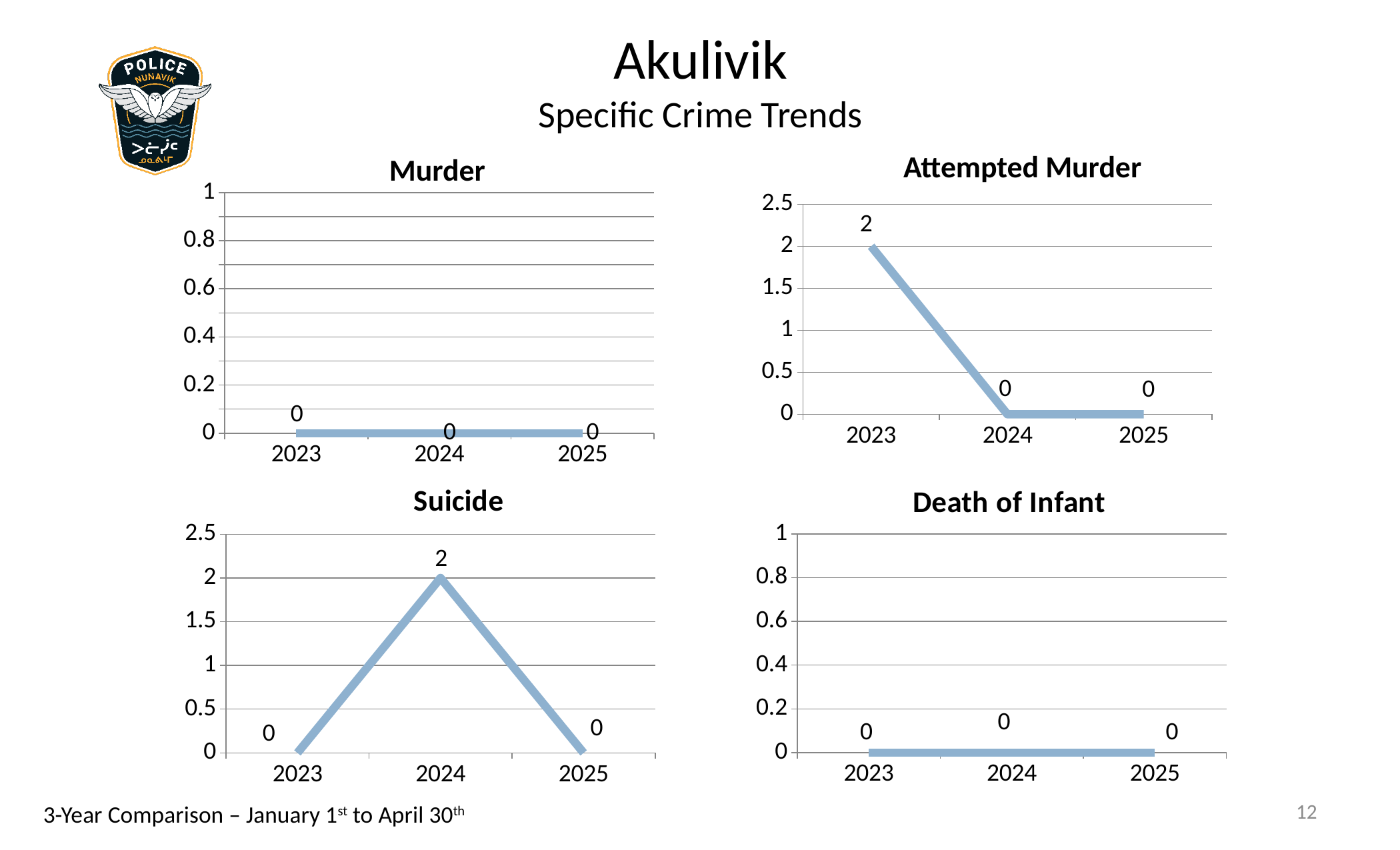
In the Attempted Murder chart, do the values rise or fall from 2023 to 2024? fall What kind of chart is the Death of Infant chart? line chart How many charts are shown on the slide? 4 In the Attempted Murder chart, what is the value for 2023? 2 In the Suicide chart, what is the value for 2024? 2 In the Attempted Murder chart, what is the difference between the 2023 value and the 2024 value? 2 In the Suicide chart, which is larger, the value for 2023 or the value for 2024? 2024 In the Murder chart, what is the value for 2025? 0 In the Suicide chart, which year has the highest value? 2024 In the Attempted Murder chart, which year has the highest value? 2023 In the Suicide chart, what is the value for 2025? 0 How many years are plotted in the Murder chart? 3